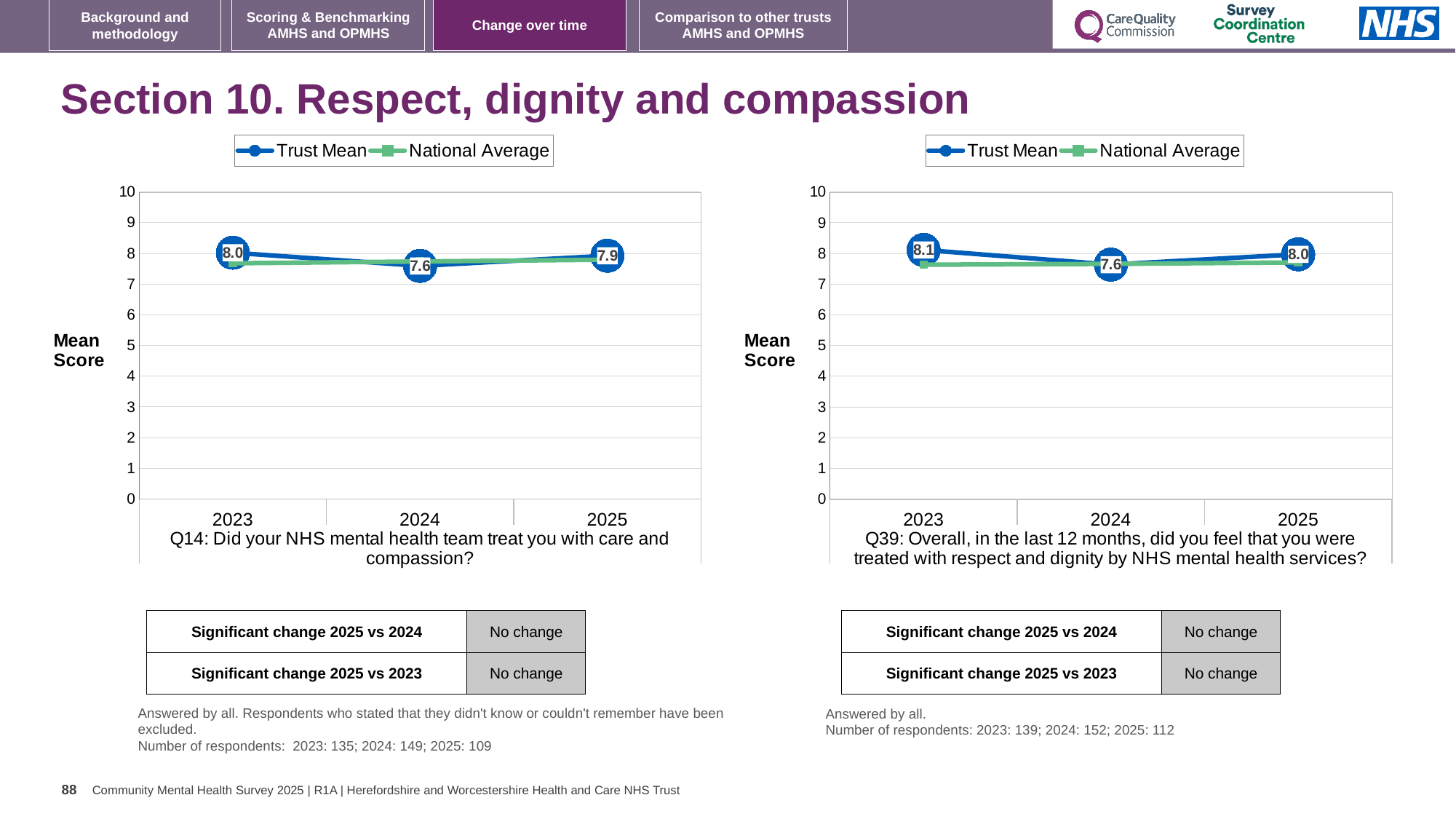
On the Q14 chart (left), is the National Average value for 2023 greater or less than 7? greater What type of chart is the Q14 chart (left)? Line chart On the Q39 chart (right), is the Trust Mean score higher in 2024 or 2025? 2025 How many series does the legend of the Q39 chart (right) list? 2 On the Q14 chart (left), what is the Trust Mean score for 2025? 7.9 On the Q39 chart (right), what is the difference between the Trust Mean scores for 2023 and 2024? 0.5 On the Q39 chart (right), which year has the highest Trust Mean score? 2023 On the Q39 chart (right), what is the Trust Mean score for 2025? 8.0 On the Q14 chart (left), which year has the lowest Trust Mean score? 2024 On the Q14 chart (left), what is the difference between the Trust Mean scores for 2023 and 2024? 0.4 On the Q14 chart (left), what is the Trust Mean score for 2024? 7.6 On the Q39 chart (right), what is the Trust Mean score for 2023? 8.1